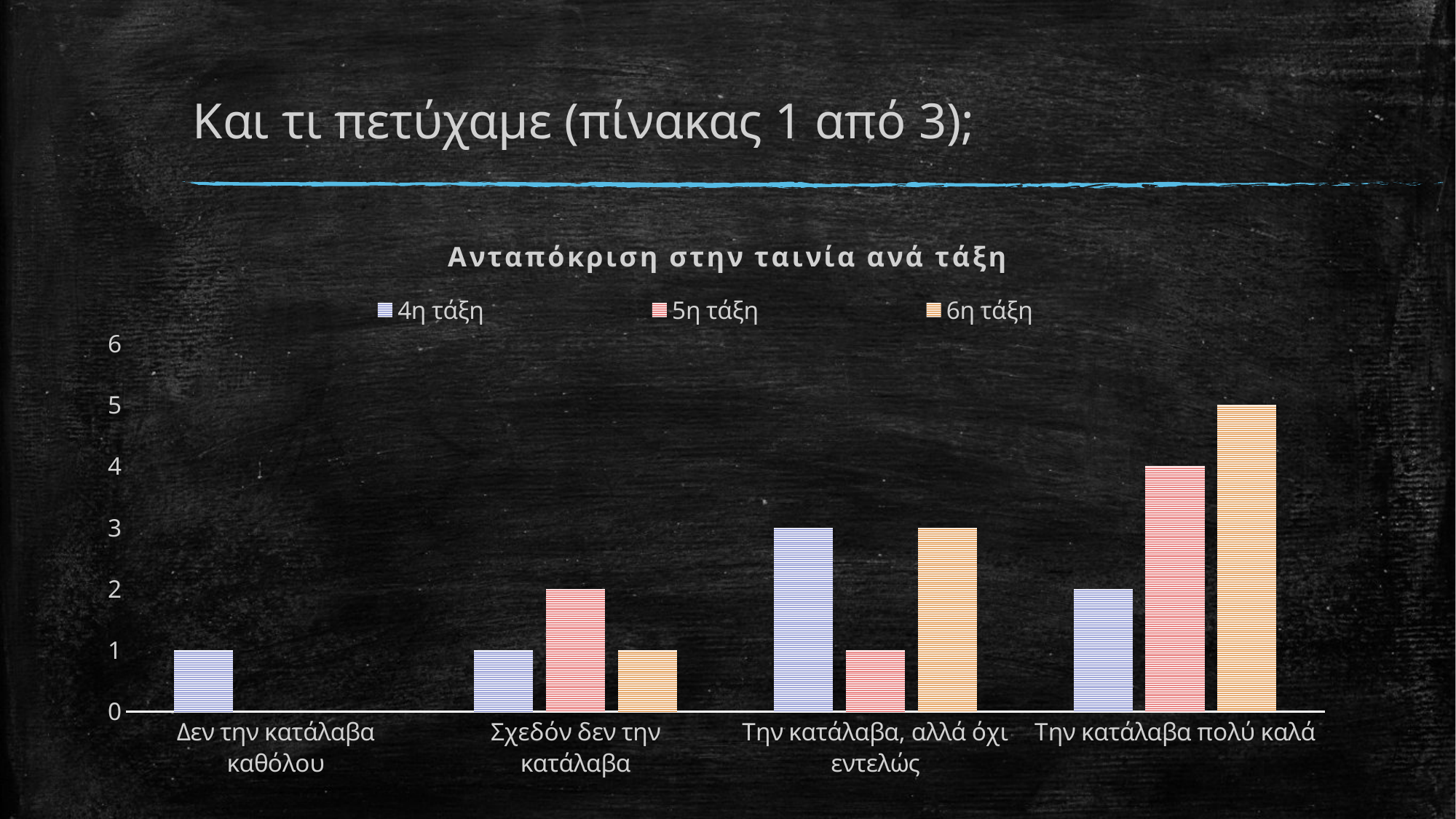
How many series does the legend list? 3 Which is larger in the category 'Σχεδόν δεν την κατάλαβα': the value for 5η τάξη or for 6η τάξη? 5η τάξη What type of chart is shown on the slide? bar chart Which series has the highest value in the category 'Την κατάλαβα πολύ καλά'? 6η τάξη What is the difference between the 6η τάξη and 4η τάξη values in the category 'Την κατάλαβα πολύ καλά'? 3 Which series is shown in orange? 6η τάξη How many categories are shown on the x axis? 4 What is the title of the chart? Ανταπόκριση στην ταινία ανά τάξη What is the value for 6η τάξη in the category 'Την κατάλαβα πολύ καλά'? 5 What is the value for 5η τάξη in the category 'Σχεδόν δεν την κατάλαβα'? 2 What is the value for 4η τάξη in the category 'Την κατάλαβα, αλλά όχι εντελώς'? 3 Which series has the lowest value in the category 'Την κατάλαβα, αλλά όχι εντελώς'? 5η τάξη